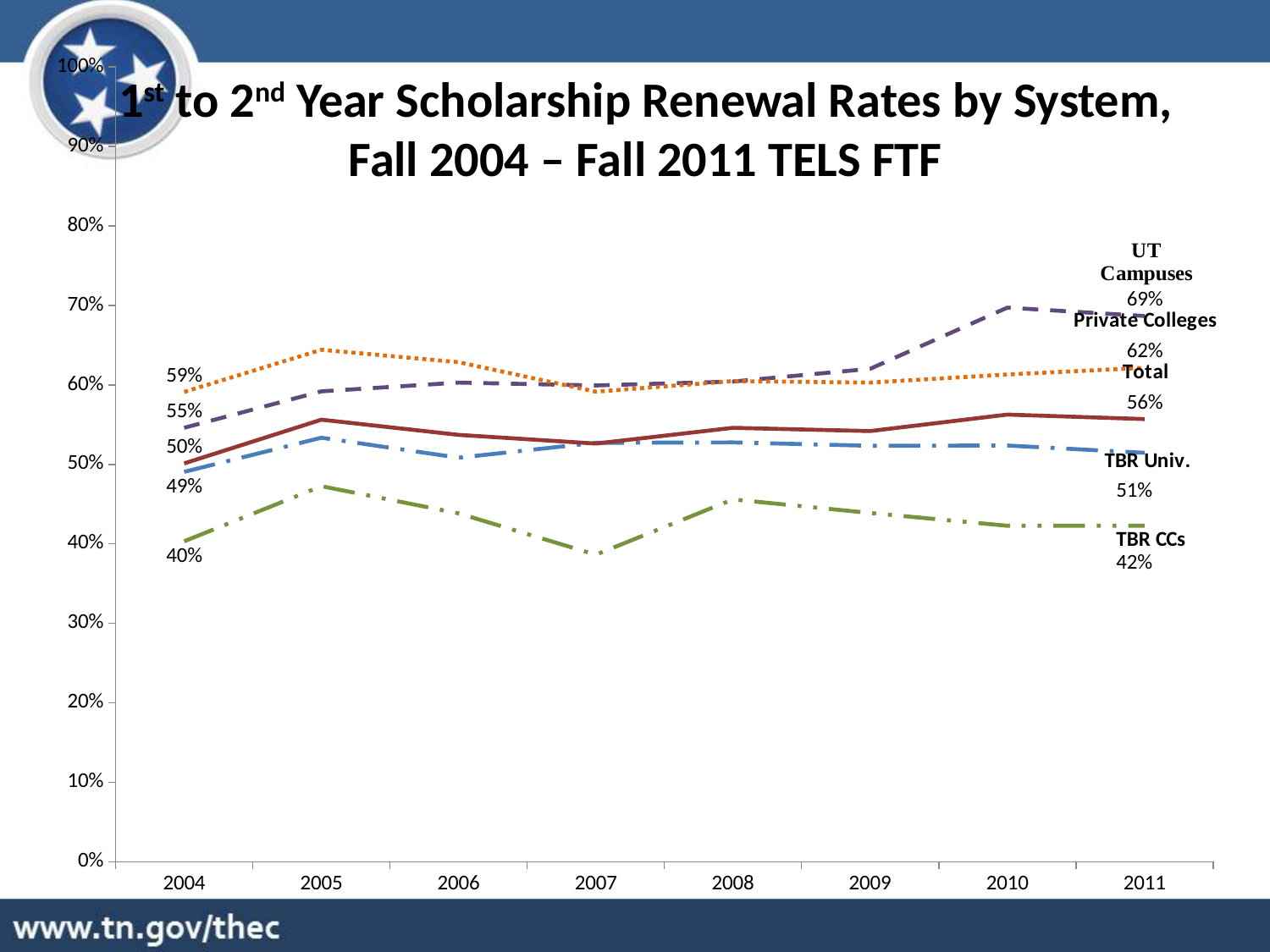
What is the renewal rate for Private Colleges in 2004? 59% By how many percentage points did the UT Campuses renewal rate change from 2004 (55%) to 2011 (69%)? 14 percentage points What is the renewal rate for TBR Univ. in 2011? 51% Which system has the highest renewal rate in 2011? UT Campuses How many years are shown on the x axis? 8 What is the Total renewal rate in 2011? 56% What type of chart is shown on the slide? line chart What is the renewal rate for UT Campuses in 2011? 69% Which system has the lowest renewal rate in 2004? TBR CCs In 2011, which is larger: the renewal rate for Private Colleges or for Total? Private Colleges What is the renewal rate for TBR CCs in 2004? 40%